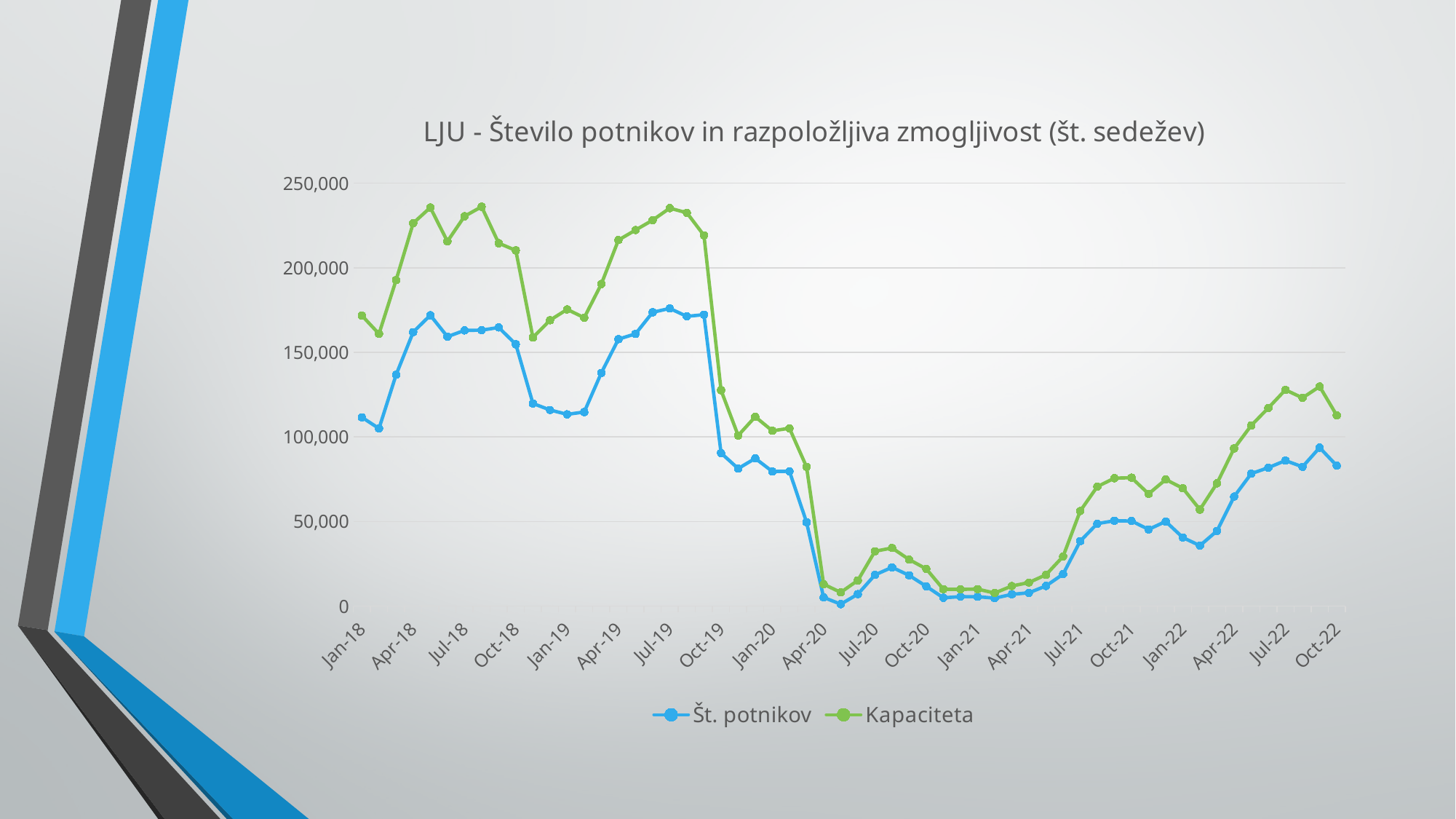
What kind of chart is shown on the slide? line chart In Jan-18, which series has the larger value, Št. potnikov or Kapaciteta? Kapaciteta Do the values of Št. potnikov rise or fall from Jan-20 to Apr-20? fall Is the value of Št. potnikov for Apr-20 greater or less than 50,000? less How many series does the legend list? 2 Is the value of Kapaciteta for Jan-18 greater or less than 150,000? greater Which series is drawn in green? Kapaciteta Is the value of Kapaciteta for Jul-19 greater or less than 200,000? greater What is the title of the chart? LJU - Število potnikov in razpoložljiva zmogljivost (št. sedežev) For Št. potnikov, which is larger: the value for Jul-19 or the value for Jul-20? Jul-19